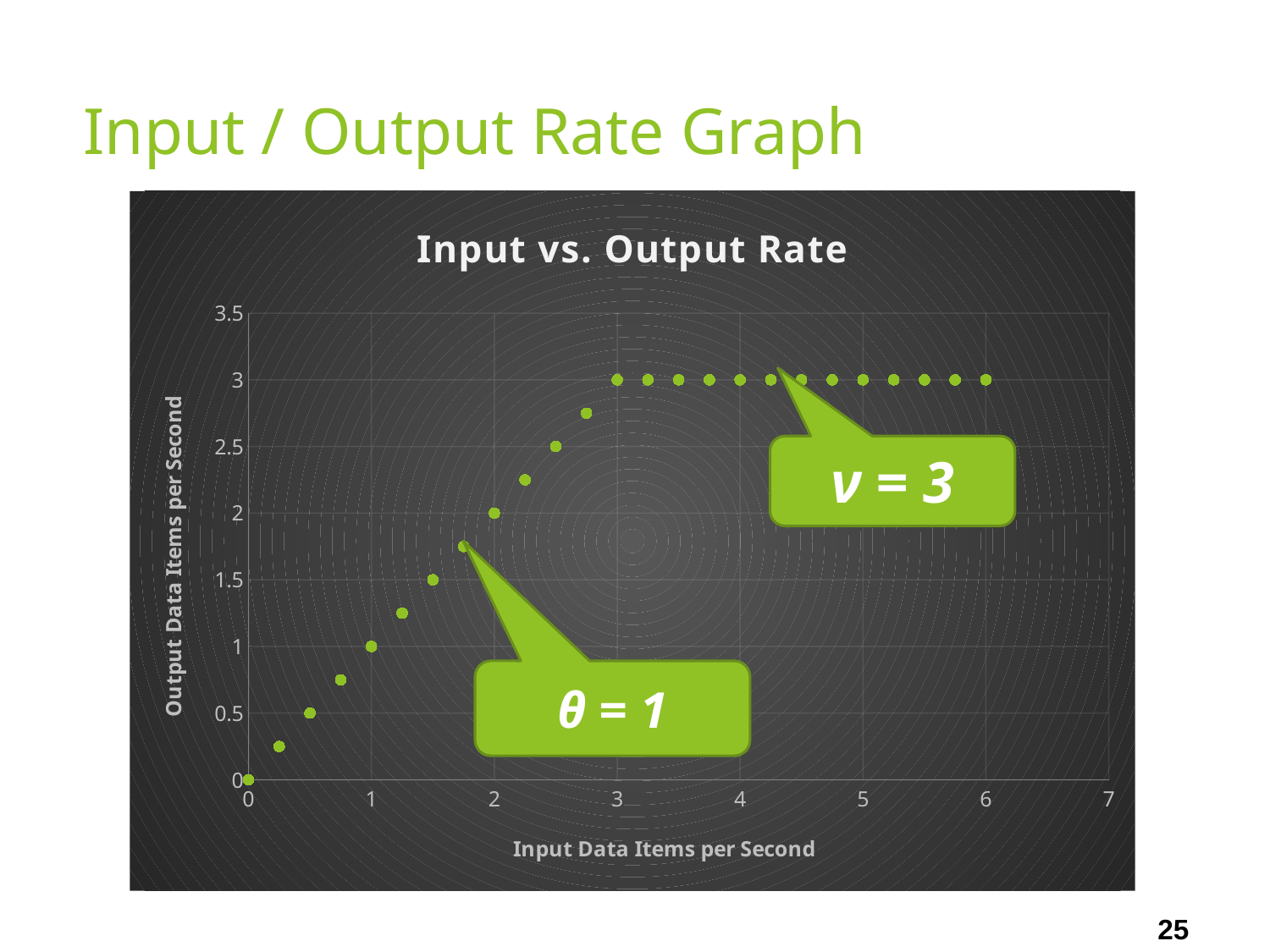
What is the difference between the output rate at input 3 and the output rate at input 1? 2 What is the title of the chart? Input vs. Output Rate Which has the larger output rate: an input rate of 1 or an input rate of 4? input rate of 4 What is the output rate when the input rate is 6? 3 What kind of chart is shown on the slide? scatter chart What is the output rate when the input rate is 1? 1 Is the output rate at an input rate of 5 greater or less than 2.5? greater How does the output rate change as the input rate increases along the x axis? rises, then levels off at 3 What is the highest output rate reached on the chart? 3 What is the output rate when the input rate is 3? 3 What is the output rate when the input rate is 2? 2 What is the label of the x axis? Input Data Items per Second